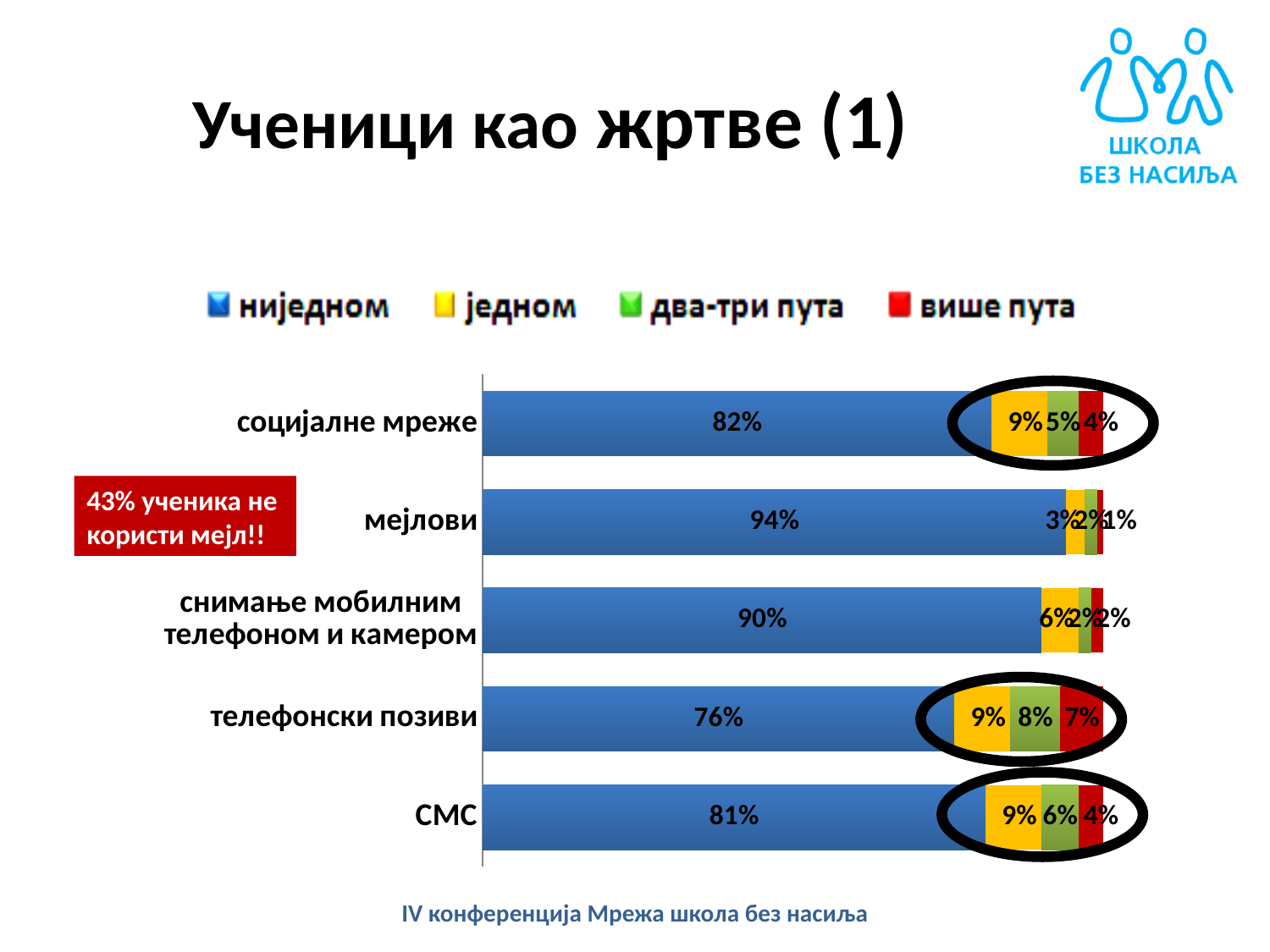
How many series does the legend list? 4 What is the value of "више пута" for "телефонски позиви"? 7% What is the difference between the "ниједном" values for "мејлови" and "телефонски позиви"? 18% Which category has the highest value for "ниједном"? мејлови Which category has the lowest value for "ниједном"? телефонски позиви What kind of chart is shown on the slide? stacked bar chart What is the value of "ниједном" for "мејлови"? 94% How many categories are plotted on the chart? 5 Which is larger: the "једном" value for "снимање мобилним телефоном и камером" or for "СМС"? СМС What is the value of "два-три пута" for "СМС"? 6% Which series is shown in red in the legend? више пута What is the value of "ниједном" for "социјалне мреже"? 82%